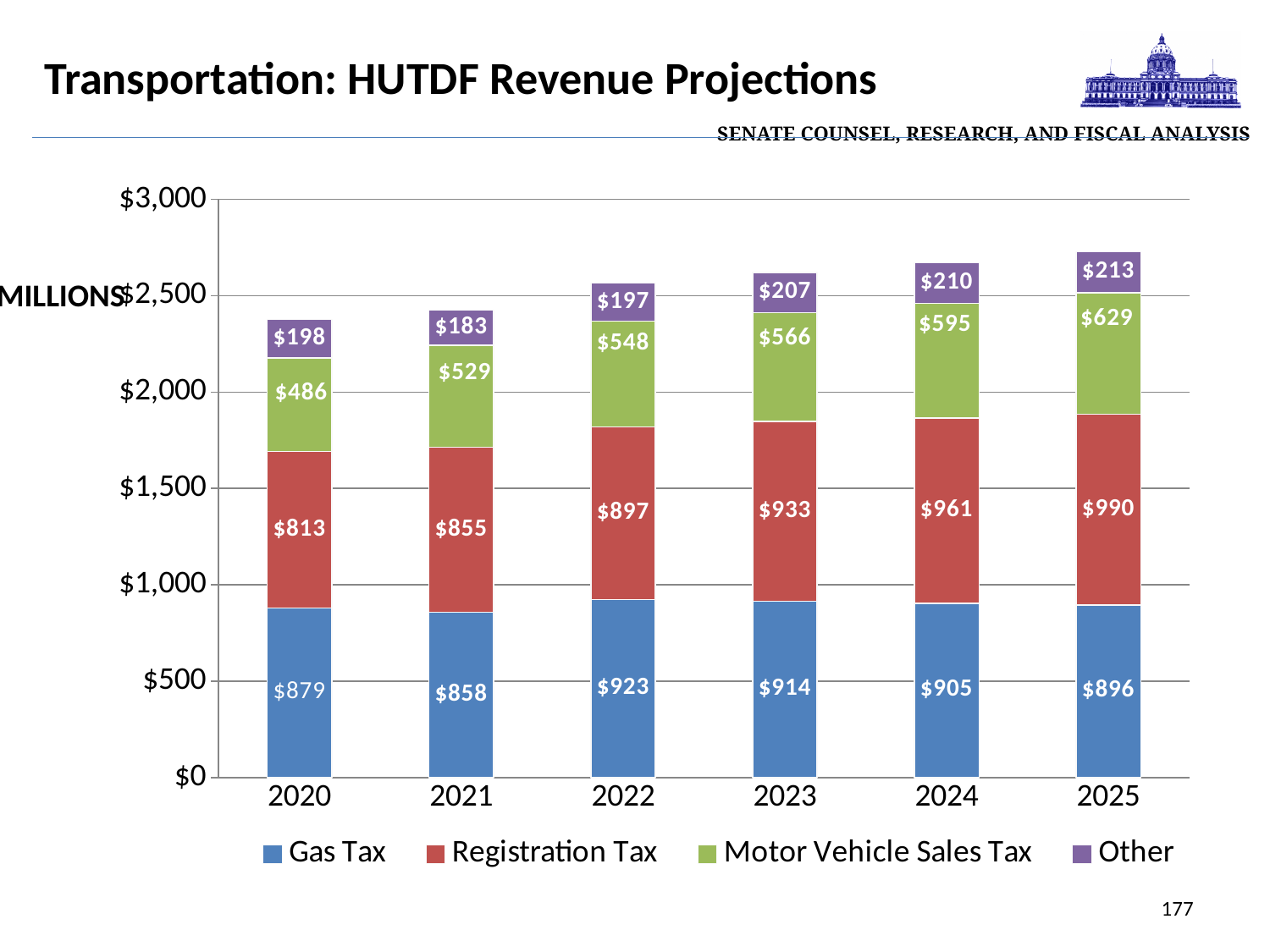
What is the difference between the Motor Vehicle Sales Tax values for 2025 and 2020? $143 What is the Registration Tax value for 2025? $990 Which year has the lowest Other value? 2021 Which is larger, the Gas Tax value for 2020 or the Gas Tax value for 2024? 2024 What is the Gas Tax value for 2022? $923 How many years are shown on the x axis? 6 What is the Motor Vehicle Sales Tax value for 2021? $529 What is the Other value for 2023? $207 Which year has the highest Registration Tax value? 2025 What is the total of the stacked bar for 2020? $2,376 What kind of chart is shown on the slide? Stacked bar chart How many series does the legend list? 4